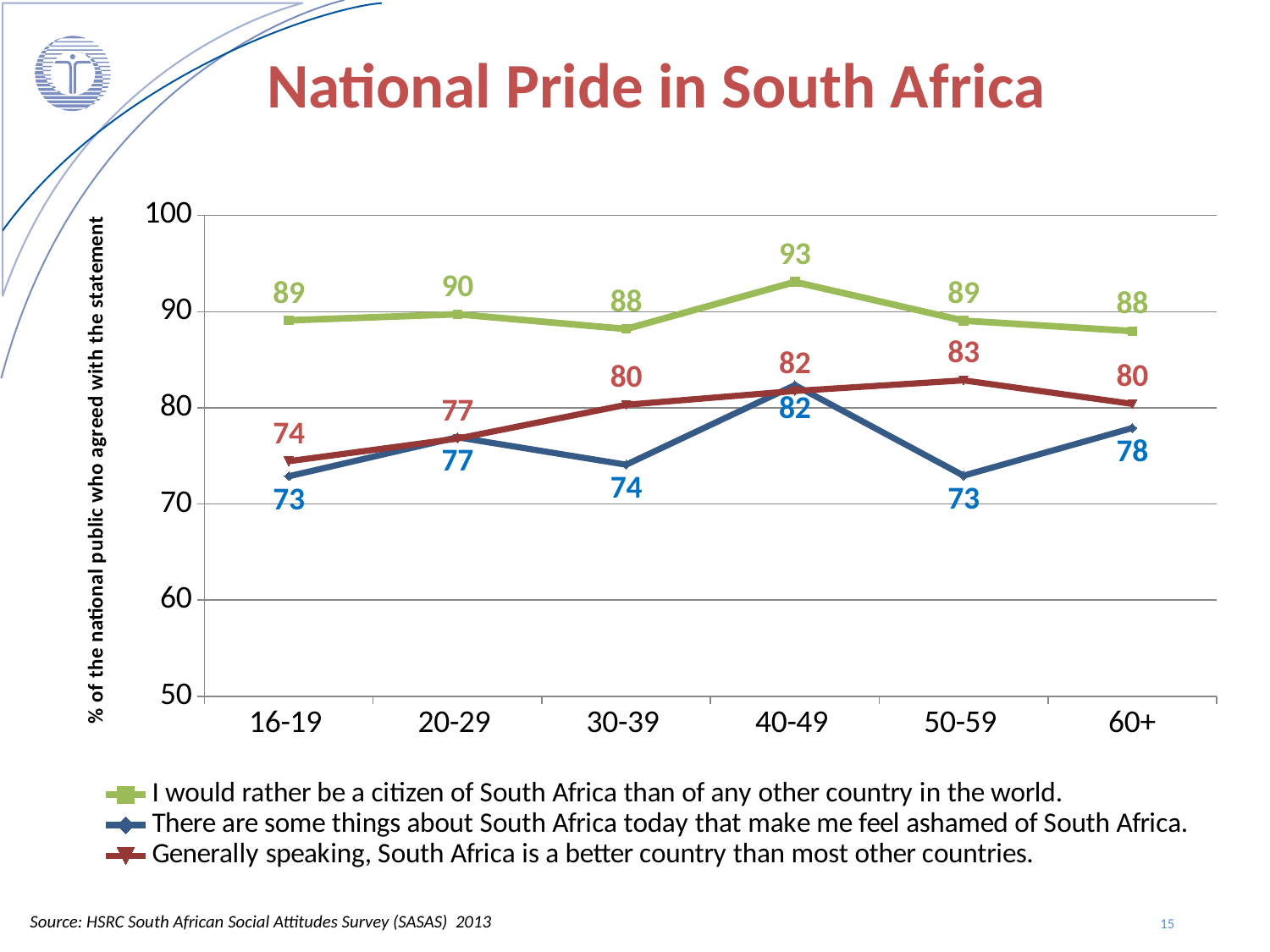
What is the value for the 16-19 age group for the statement 'There are some things about South Africa today that make me feel ashamed of South Africa'? 73 For the 30-39 age group, which is larger: the value for 'Generally speaking, South Africa is a better country than most other countries' or the value for 'There are some things about South Africa today that make me feel ashamed of South Africa'? Generally speaking, South Africa is a better country than most other countries How many series does the legend list? 3 Which age group has the highest value for 'I would rather be a citizen of South Africa than of any other country in the world'? 40-49 How many age groups are shown on the x axis? 6 What percentage of the 40-49 age group agreed that they would rather be a citizen of South Africa than of any other country in the world? 93 Which age group has the lowest value for 'Generally speaking, South Africa is a better country than most other countries'? 16-19 What is the value for the 50-59 age group for the statement 'Generally speaking, South Africa is a better country than most other countries'? 83 What is the difference between the 40-49 and 50-59 values for 'There are some things about South Africa today that make me feel ashamed of South Africa'? 9 What type of chart is shown on the slide? Line chart Is the value for the 60+ age group for 'I would rather be a citizen of South Africa than of any other country in the world' greater or less than 80? greater What is the title of the chart? National Pride in South Africa